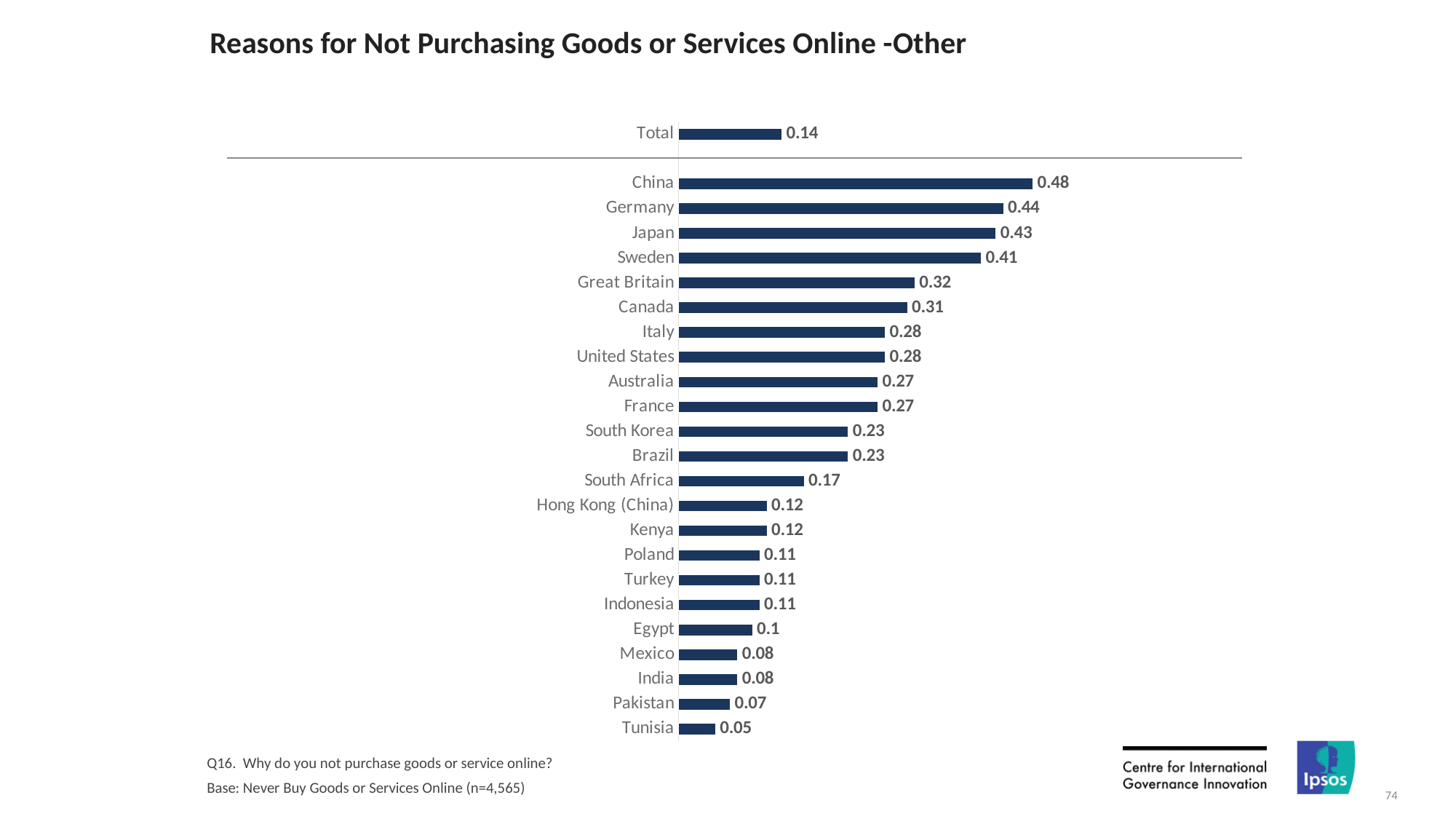
What is the value for Total? 0.14 Which has a larger value, Canada or South Korea? Canada What is the title of the chart? Reasons for Not Purchasing Goods or Services Online -Other What is the value for China? 0.48 Which country has the highest value? China What is the value for South Africa? 0.17 What is the difference between the values for Great Britain and Pakistan? 0.25 What is the value for Egypt? 0.1 Which country has the lowest value? Tunisia How many countries (excluding Total) are shown in the chart? 23 What is the difference between the values for Germany and Sweden? 0.03 What kind of chart is shown on the slide? Bar chart